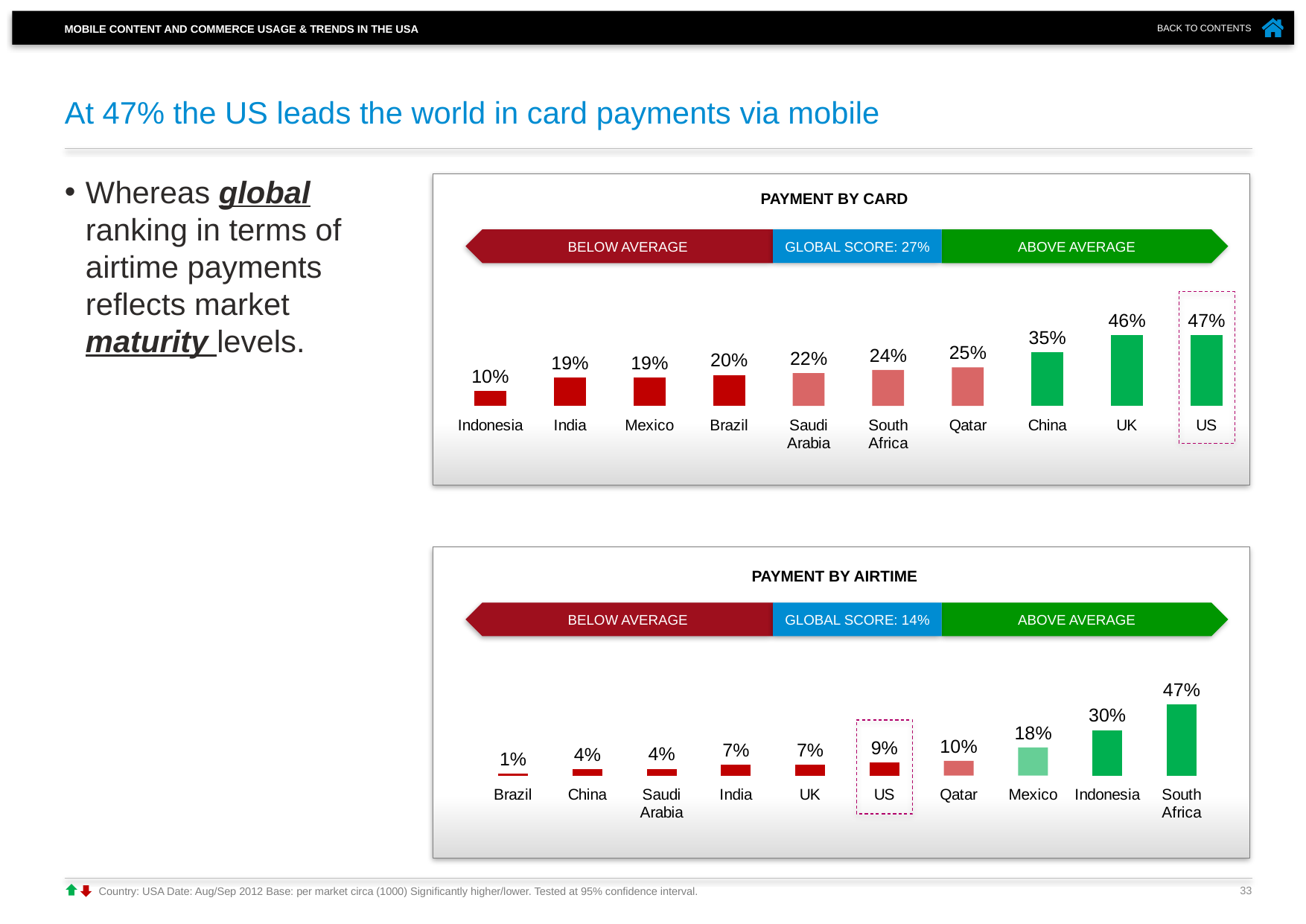
In the PAYMENT BY CARD chart, which country has the lowest value? Indonesia In the PAYMENT BY AIRTIME chart, what is the value for the US? 9% In the PAYMENT BY CARD chart, how many countries are shown? 10 In the PAYMENT BY AIRTIME chart, which country has the highest value? South Africa What kind of chart is the PAYMENT BY AIRTIME chart? Bar chart In the PAYMENT BY CARD chart, what is the value for the US? 47% In the PAYMENT BY CARD chart, what is the difference between the UK and China? 11% In the PAYMENT BY AIRTIME chart, which is larger, Indonesia or Mexico? Indonesia In the PAYMENT BY AIRTIME chart, what is the difference between South Africa and Indonesia? 17% In the PAYMENT BY CARD chart, do the values rise or fall from left to right? Rise In the PAYMENT BY AIRTIME chart, which country has the lowest value? Brazil In the PAYMENT BY CARD chart, what is the global score shown? 27%